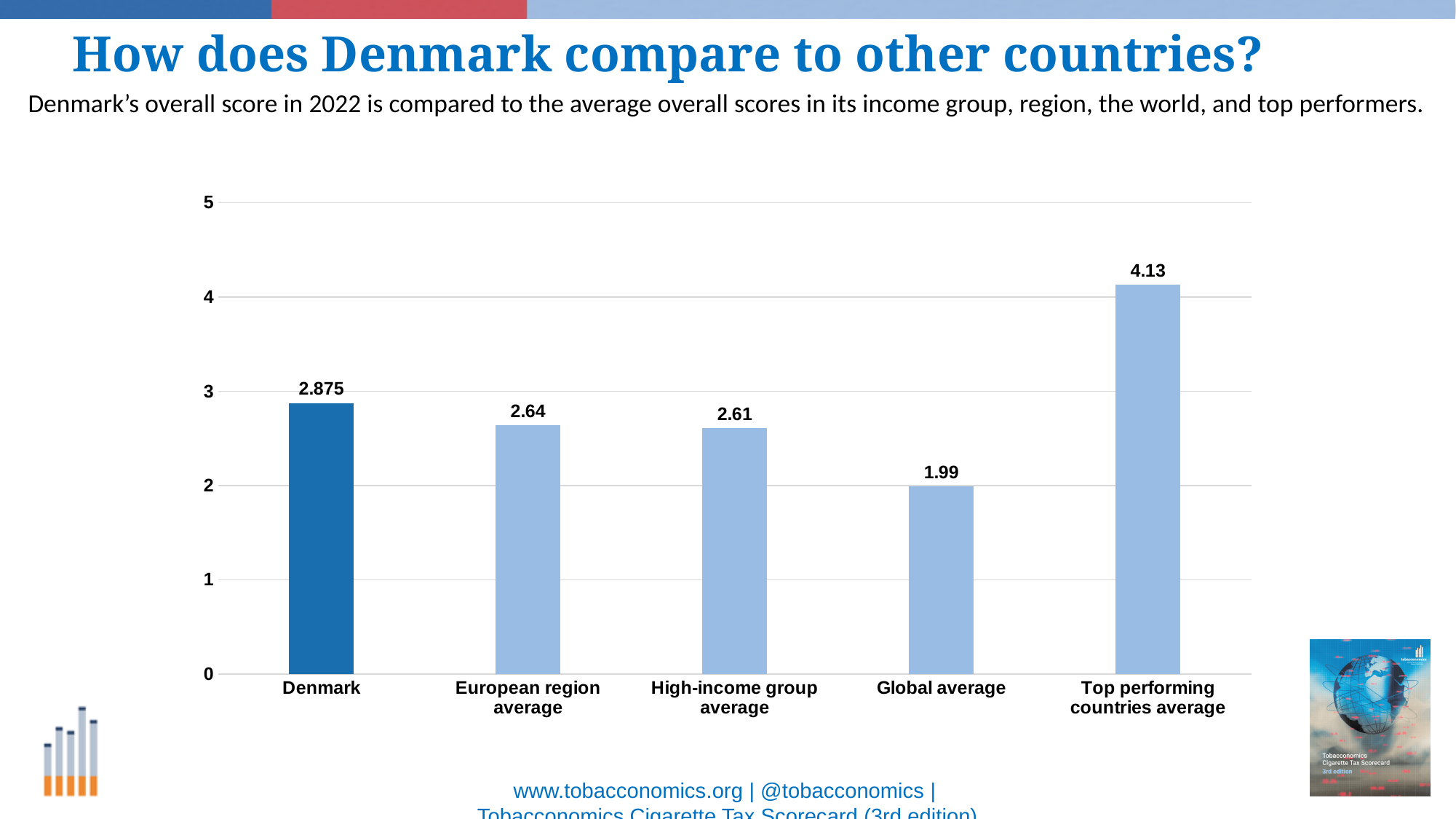
What is the value for the High-income group average? 2.61 Which category has the highest value? Top performing countries average How many categories are shown on the chart? 5 What is the value for the European region average? 2.64 Is the value for Denmark greater or less than 3? less What is the value for the Global average? 1.99 What is the value for Denmark? 2.875 Which is larger, Denmark or the Global average? Denmark What is the value for the Top performing countries average? 4.13 Which category has the lowest value? Global average What is the difference between the Top performing countries average and Denmark? 1.255 What kind of chart is shown on the slide? Bar chart